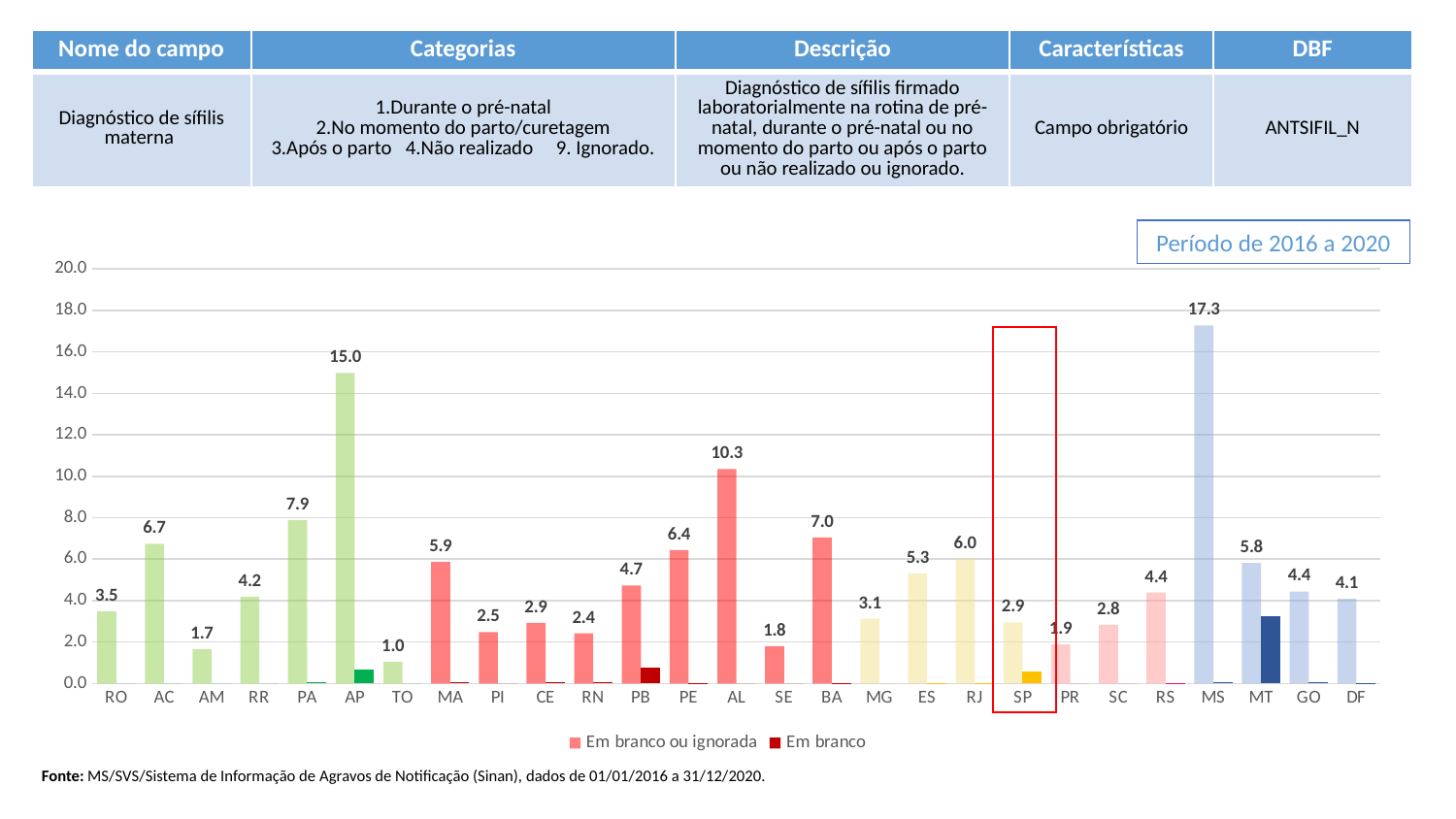
What period does the chart cover, according to the box above it? Período de 2016 a 2020 What is the 'Em branco ou ignorada' value for AL? 10.3 How many series does the legend list? 2 What is the 'Em branco ou ignorada' value for SP? 2.9 Which state has the lowest 'Em branco ou ignorada' value? TO What is the 'Em branco ou ignorada' value for AP? 15.0 Is the 'Em branco' value for MT greater or less than 2.0? greater Which state has the highest 'Em branco ou ignorada' value? MS What is the difference between the 'Em branco ou ignorada' values for MS and AP? 2.3 Which has a larger 'Em branco ou ignorada' value, PA or AC? PA What kind of chart is shown on the slide? bar chart How many states are shown on the x axis of the chart? 27